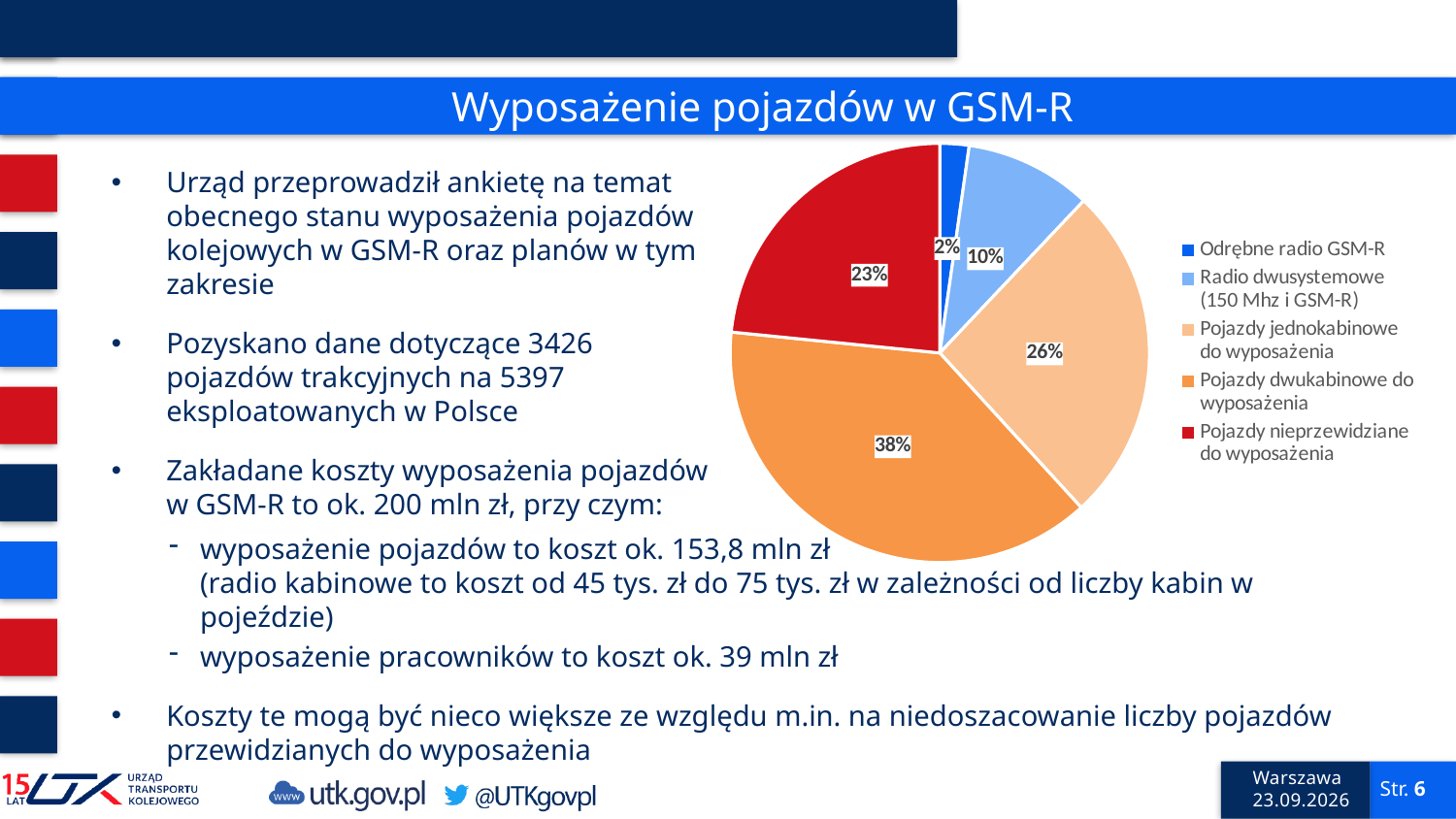
What colour is the slice for 'Pojazdy nieprzewidziane do wyposażenia'? red Which category has the largest slice of the pie? Pojazdy dwukabinowe do wyposażenia What share of the pie is 'Pojazdy nieprzewidziane do wyposażenia'? 23% What share of the pie is 'Odrębne radio GSM-R'? 2% What is the difference in percentage points between 'Pojazdy dwukabinowe do wyposażenia' and 'Pojazdy jednokabinowe do wyposażenia'? 12 Which category has the smallest slice of the pie? Odrębne radio GSM-R What share of the pie is 'Pojazdy dwukabinowe do wyposażenia'? 38% How many slices does the pie chart have? 5 What kind of chart is shown on the slide? pie chart Which is larger: the slice for 'Pojazdy jednokabinowe do wyposażenia' or the slice for 'Pojazdy nieprzewidziane do wyposażenia'? Pojazdy jednokabinowe do wyposażenia How many entries does the legend of the pie chart list? 5